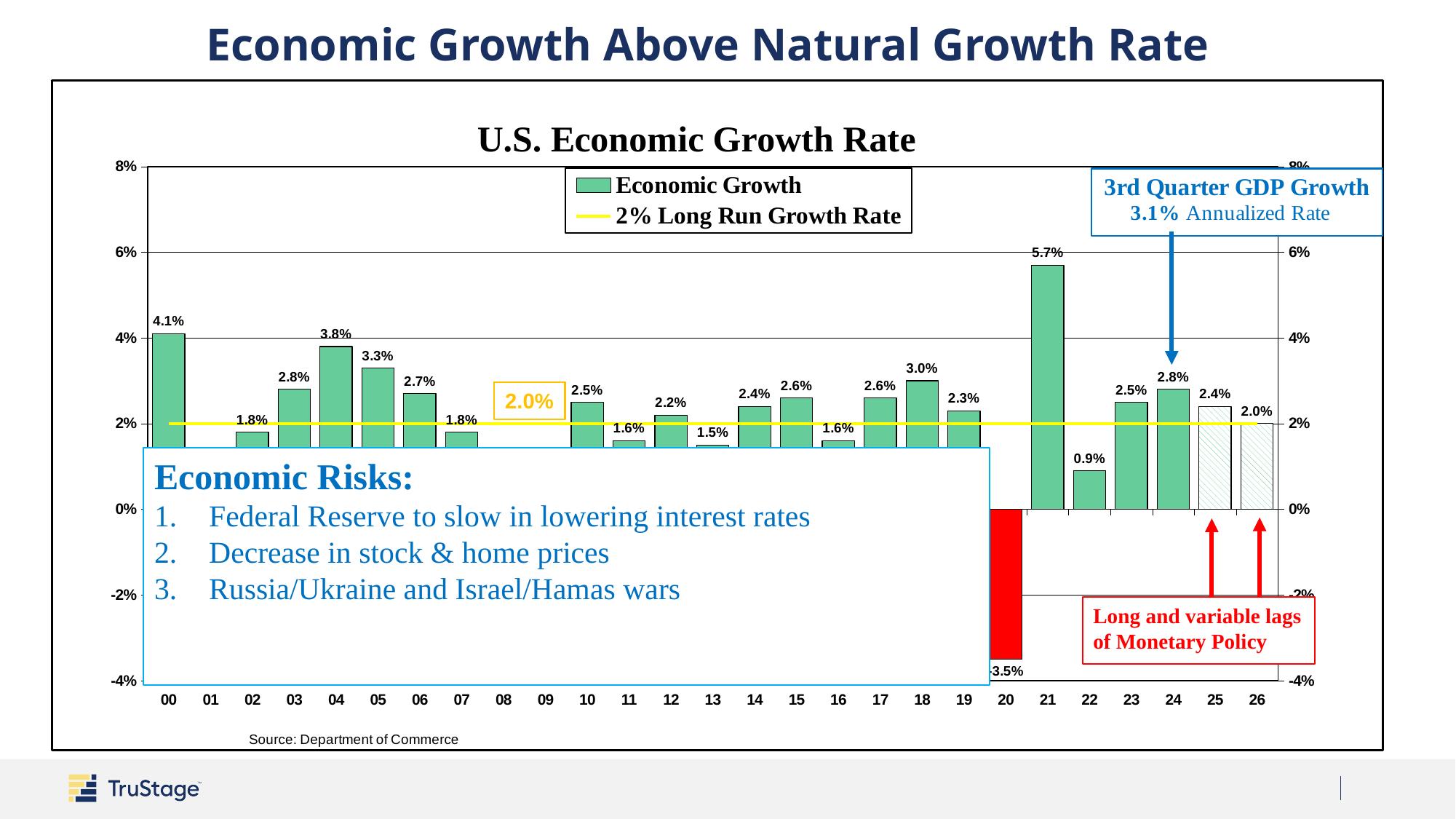
What is the economic growth rate shown for 04? 3.8% What is the title of the chart? U.S. Economic Growth Rate What kind of chart is used to show the economic growth rate? Bar chart Which year has the lowest economic growth rate on the chart? 20 Which year has the higher growth rate, 05 or 06? 05 How many series does the legend list? 2 Is the value for 21 greater or less than 4%? greater What is the economic growth rate shown for 21? 5.7% What is the economic growth rate shown for 26? 2.0% What is the economic growth rate shown for 22? 0.9% Which year has the highest economic growth rate on the chart? 21 What is the difference between the growth rates for 18 and 19? 0.7 percentage points